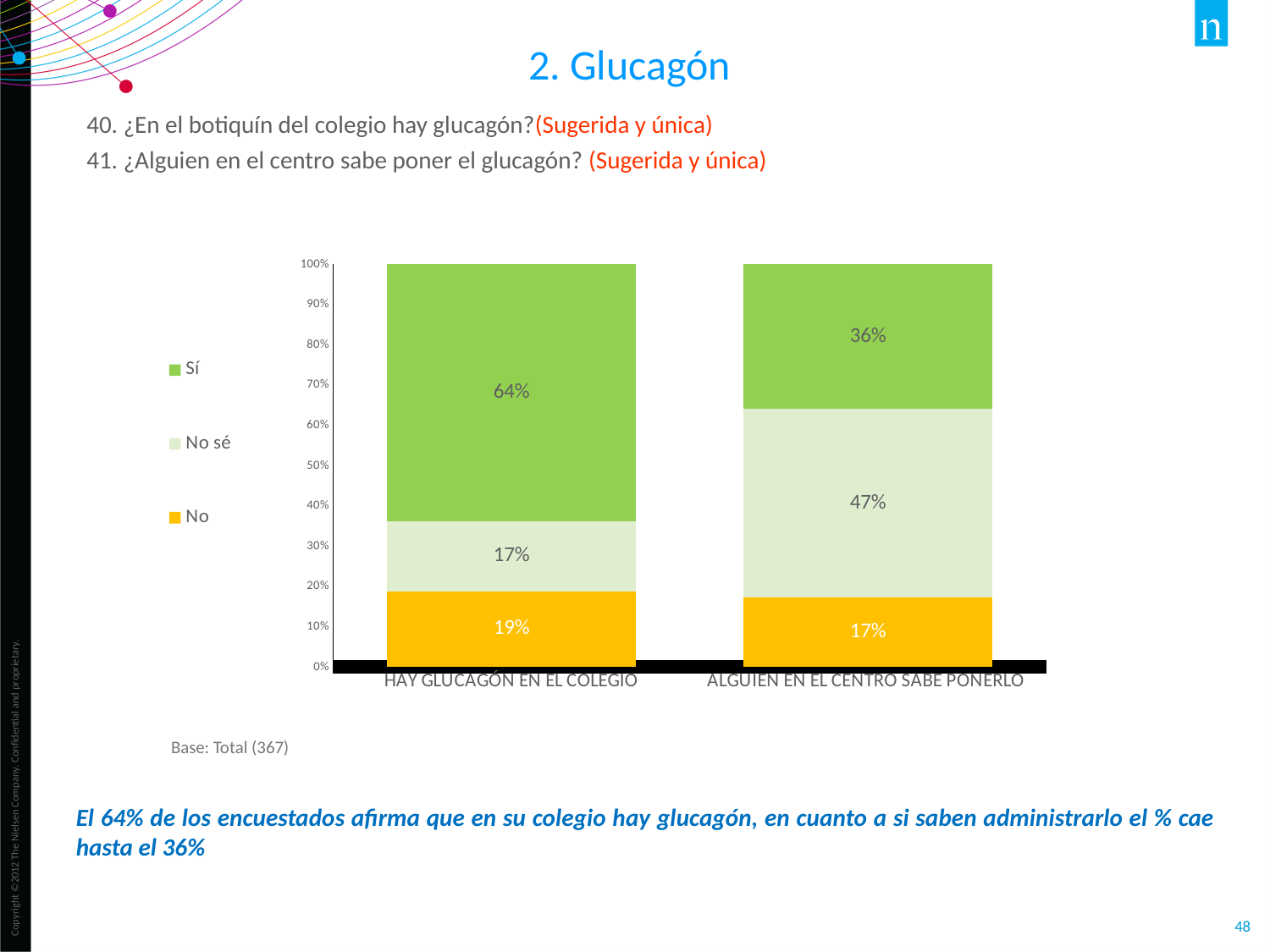
What is the value of "No sé" for "HAY GLUCAGÓN EN EL COLEGIO"? 17% How many series does the legend list? 3 What kind of chart is shown on the slide? Stacked bar chart What is the value of "No" for "HAY GLUCAGÓN EN EL COLEGIO"? 19% What is the difference between the "Sí" values for "HAY GLUCAGÓN EN EL COLEGIO" and "ALGUIEN EN EL CENTRO SABE PONERLO"? 28% How many categories are shown on the x axis? 2 What is the value of "Sí" for "HAY GLUCAGÓN EN EL COLEGIO"? 64% What is the value of "No sé" for "ALGUIEN EN EL CENTRO SABE PONERLO"? 47% Which category has the highest "Sí" value? HAY GLUCAGÓN EN EL COLEGIO Which category has the lowest "No" value? ALGUIEN EN EL CENTRO SABE PONERLO What is the value of "Sí" for "ALGUIEN EN EL CENTRO SABE PONERLO"? 36% Which is larger for "ALGUIEN EN EL CENTRO SABE PONERLO": "No sé" or "Sí"? No sé